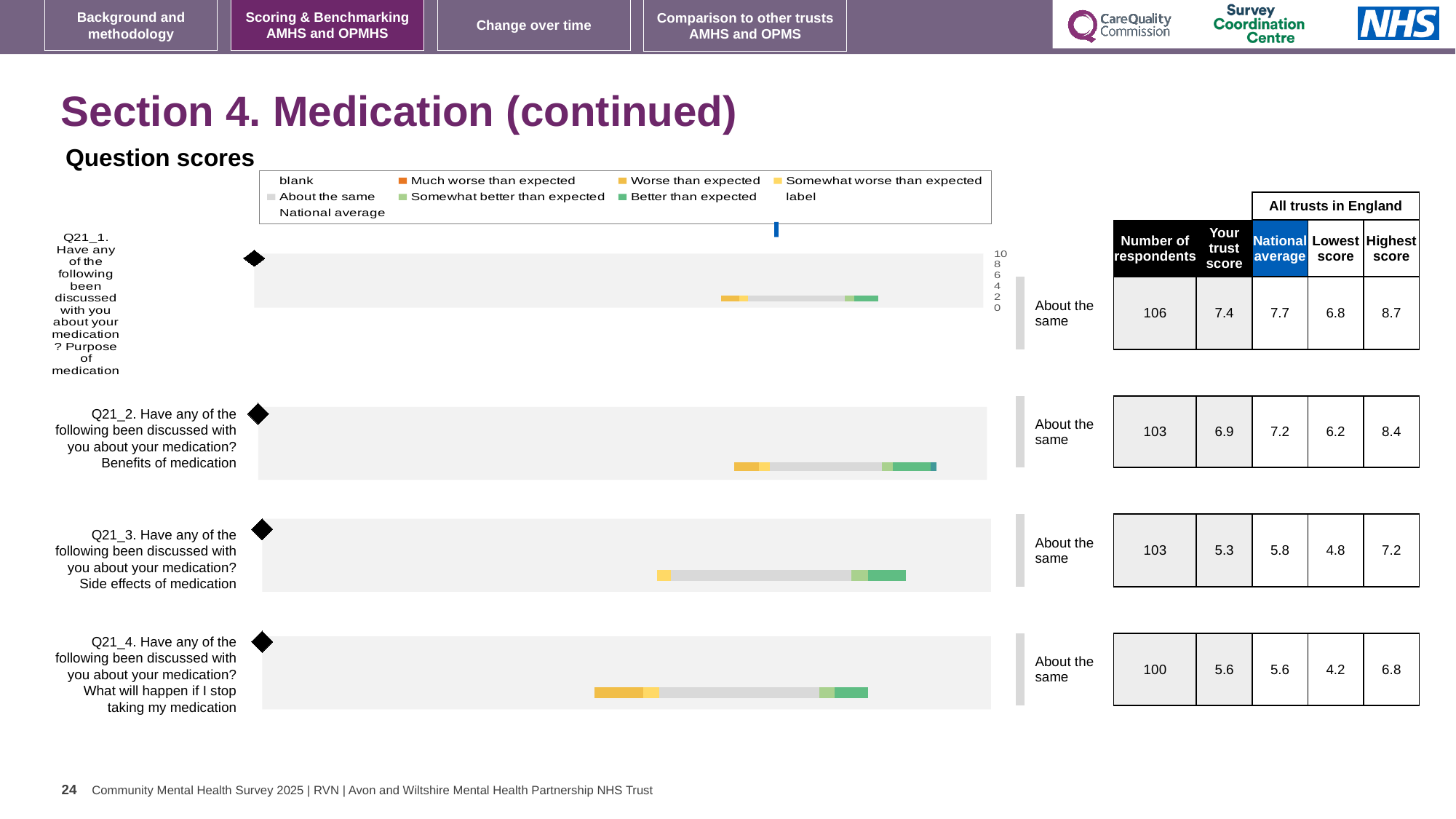
Which legend entry is shown in light grey? About the same For the Q21_4 'What will happen if I stop taking my medication' chart, what is the highest score shown on the slide? 6.8 Is the trust score for the Q21_2 'Benefits of medication' chart larger or smaller than the national average? smaller Which of the four question charts has the highest trust score shown on the slide? Q21_1. Purpose of medication Which legend entry is shown in orange? Much worse than expected For the Q21_2 'Benefits of medication' chart, what is the trust score shown on the slide? 6.9 How many entries does the shared legend above the charts list? 9 For the Q21_3 'Side effects of medication' chart, what is the national average shown on the slide? 5.8 What is the difference between the national average and the trust score for the Q21_1 'Purpose of medication' chart? 0.3 Which of the four question charts has the lowest trust score shown on the slide? Q21_3. Side effects of medication What kind of chart is used for the Q21_1 'Purpose of medication' row? bar chart How many question-score bar charts are shown on the slide? 4